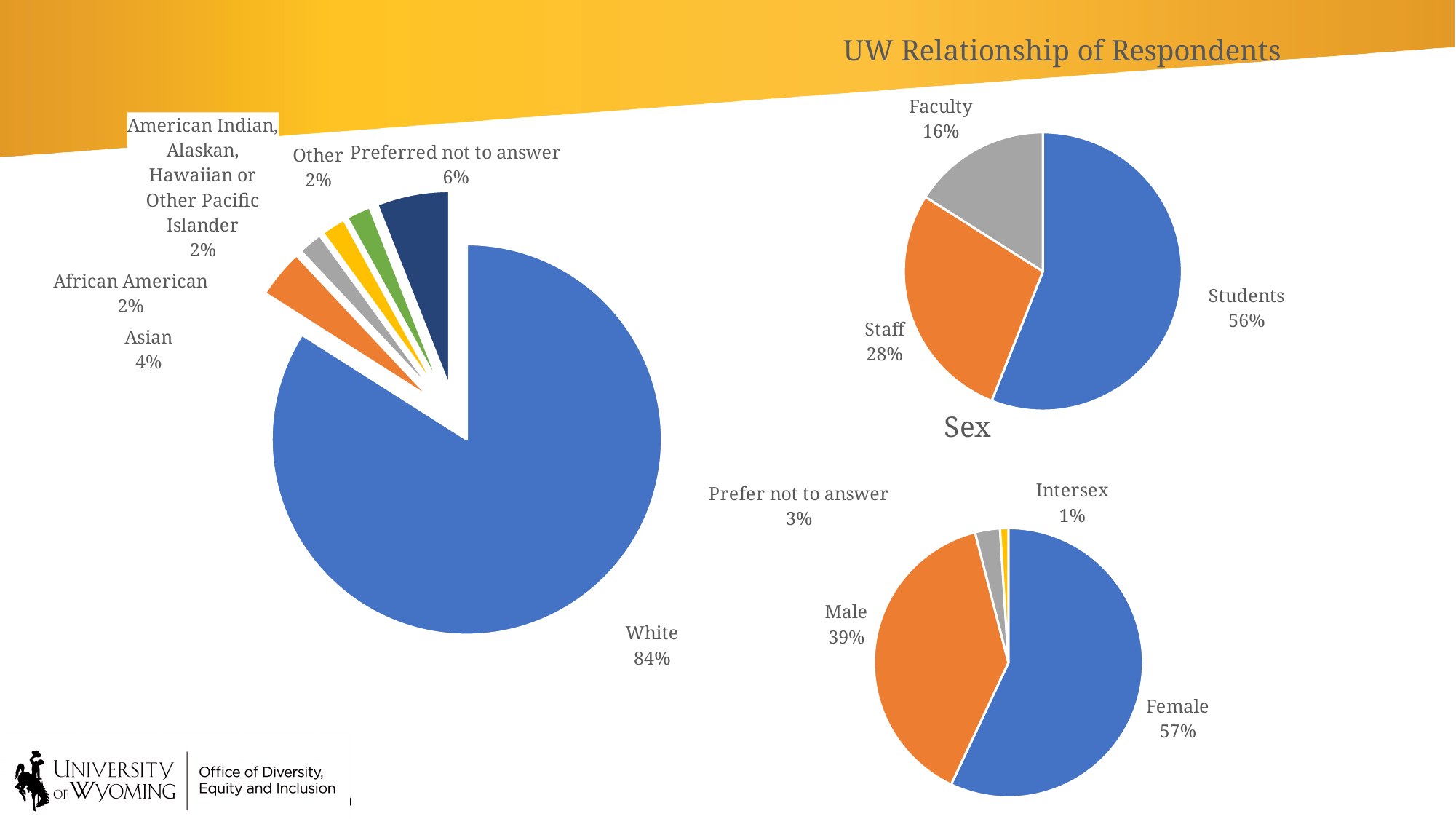
In the pie chart on the left side of the slide, which is larger: Preferred not to answer or Asian? Preferred not to answer In the pie chart on the left side of the slide, what percentage of respondents are White? 84% In the Sex chart, which category has the largest share? Female In the UW Relationship of Respondents chart, what percentage of respondents are Students? 56% What type of chart is used for the UW Relationship of Respondents? Pie chart In the UW Relationship of Respondents chart, what percentage of respondents are Faculty? 16% In the Sex chart, how many categories are shown? 4 In the pie chart on the left side of the slide, what percentage of respondents are Asian? 4% In the Sex chart, what percentage of respondents are Male? 39% In the UW Relationship of Respondents chart, what is the difference in percentage points between Students and Staff? 28 In the UW Relationship of Respondents chart, which category has the smallest share? Faculty In the Sex chart, what percentage of respondents are Intersex? 1%